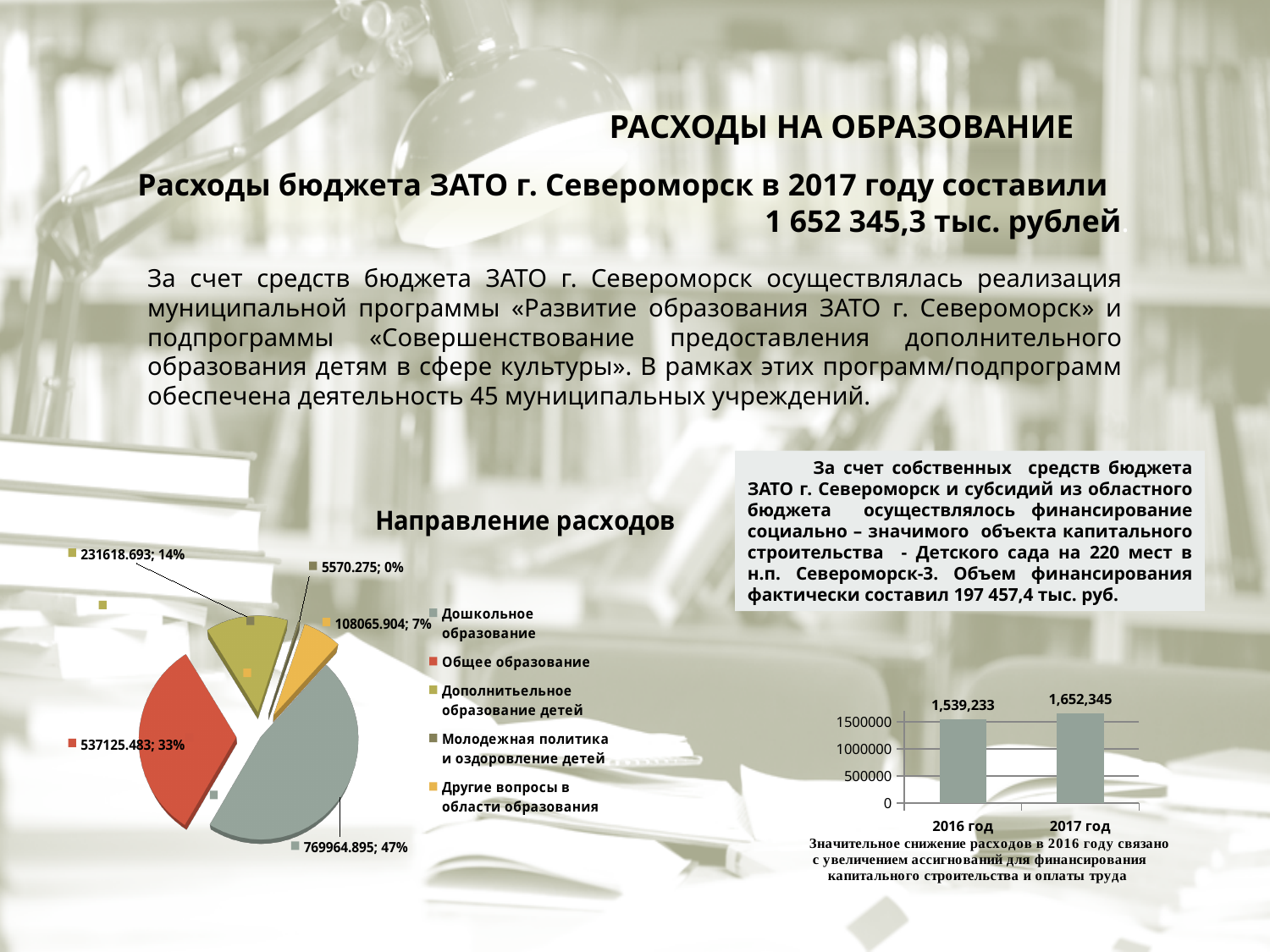
In the bar chart at the bottom right, do the values rise or fall from 2016 год to 2017 год? rise In the bar chart at the bottom right, what is the value for 2017 год? 1,652,345 In the pie chart "Направление расходов", what share is shown for the slice with value 108065.904? 7% In the bar chart at the bottom right, what is the value for 2016 год? 1,539,233 What type of chart is the chart titled "Направление расходов"? pie chart In the pie chart "Направление расходов", how many categories does the legend list? 5 What type of chart is the chart at the bottom right showing 2016 год and 2017 год? bar chart In the pie chart "Направление расходов", which is larger: the slice with 33% or the slice with 14%? the slice with 33% In the pie chart "Направление расходов", what is the value shown for the slice labelled with 33%? 537125.483 In the pie chart "Направление расходов", what share does the largest slice (Дошкольное образование) have? 47% In the pie chart "Направление расходов", which category has the smallest slice? Молодежная политика и оздоровление детей In the pie chart "Направление расходов", what share is shown for the slice with value 231618.693? 14%